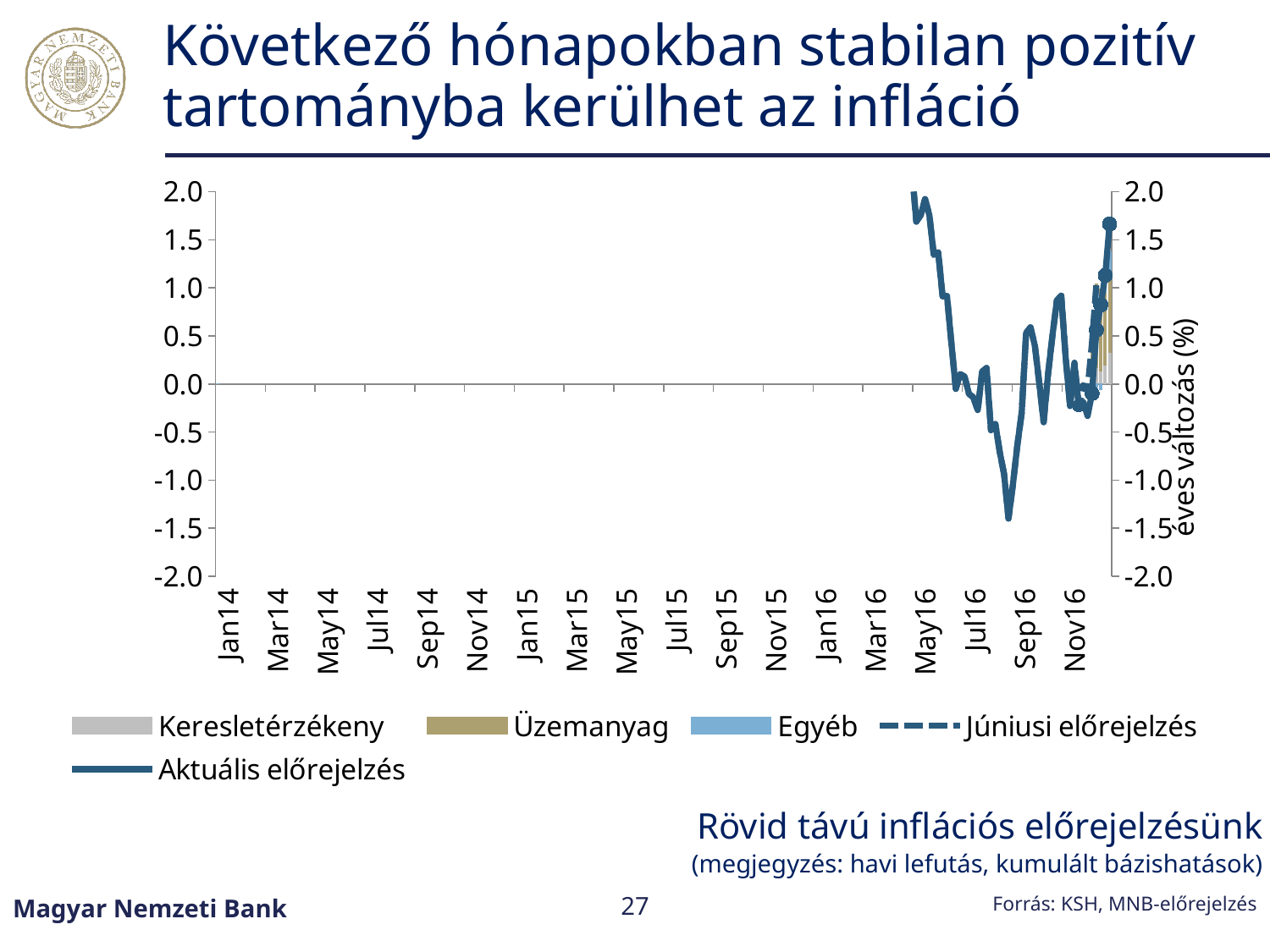
How many month labels are shown on the horizontal axis? 18 What is the highest tick value shown on the vertical axis? 2.0 Is the value of the Aktuális előrejelzés line at May16 greater or less than 1.5? greater Is the final value of the Aktuális előrejelzés line greater or less than 1.0? greater What is the label on the right-hand vertical axis? éves változás (%) Is the lowest value of the Aktuális előrejelzés line, around Sep16, greater or less than -1.0? less Does the Aktuális előrejelzés line rise or fall between May16 and Sep16? fall What kind of chart is shown on the slide? A combination chart of stacked bars and lines How many series does the legend list? 5 Does the Aktuális előrejelzés line rise or fall from its low point around Sep16 to the end of the series? rise What is the lowest tick value shown on the vertical axis? -2.0 What is the title of the chart? Rövid távú inflációs előrejelzésünk